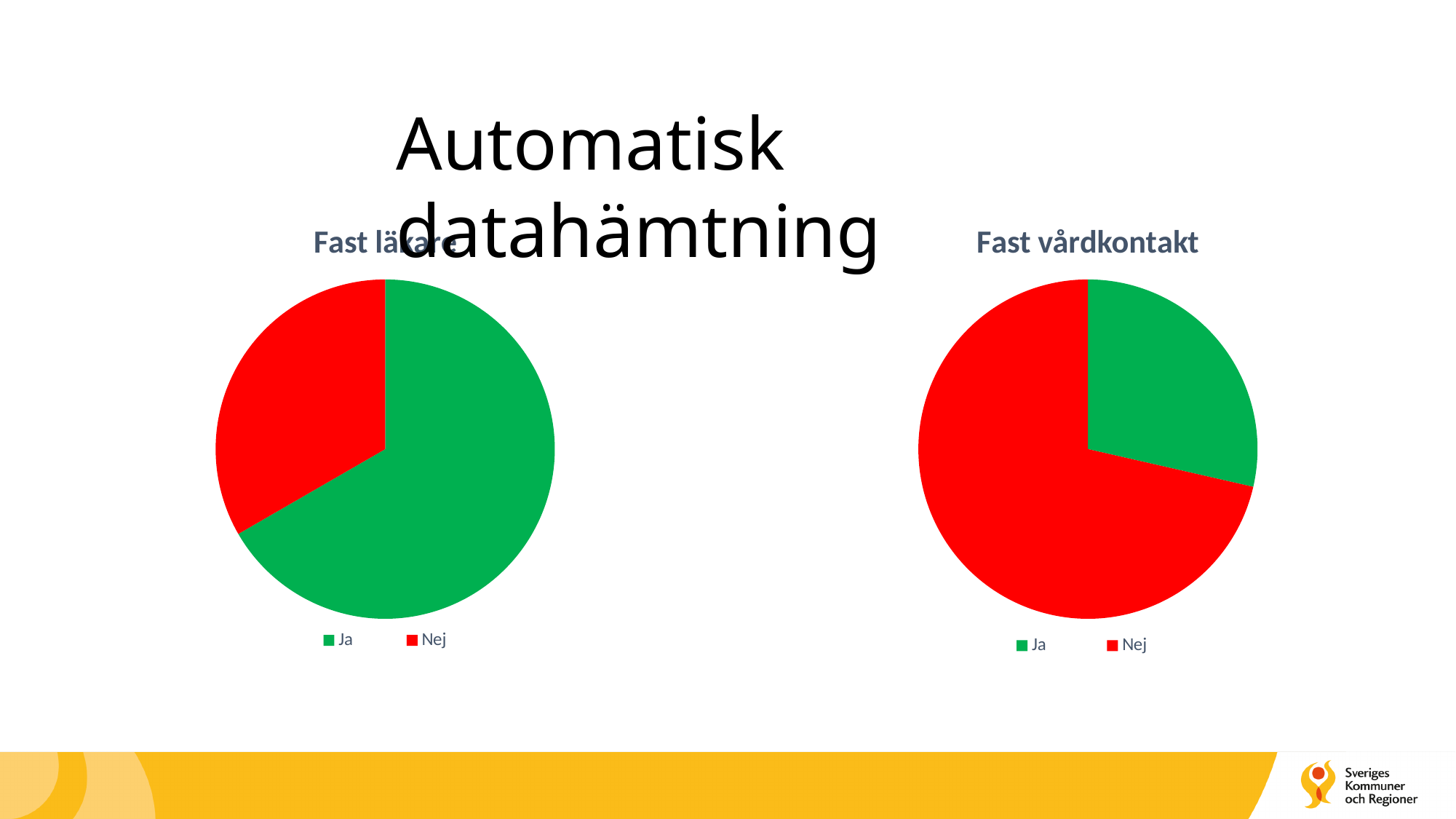
In the left pie chart, which slice is larger, Ja or Nej? Ja In the chart titled 'Fast vårdkontakt', what colour represents Nej? Red What is the title of the right-hand pie chart? Fast vårdkontakt What kind of chart is the left chart on the slide? Pie chart How many slices does the left pie chart have? 2 How many pie charts are shown on the slide? 2 What kind of chart is the chart titled 'Fast vårdkontakt'? Pie chart In the chart titled 'Fast vårdkontakt', is the Ja slice larger or smaller than the Nej slice? Smaller In the chart titled 'Fast vårdkontakt', which slice is the largest? Nej How many entries does the legend of the chart titled 'Fast vårdkontakt' list? 2 In the left pie chart, which slice is the smallest? Nej In the chart titled 'Fast vårdkontakt', which slice is the smallest? Ja